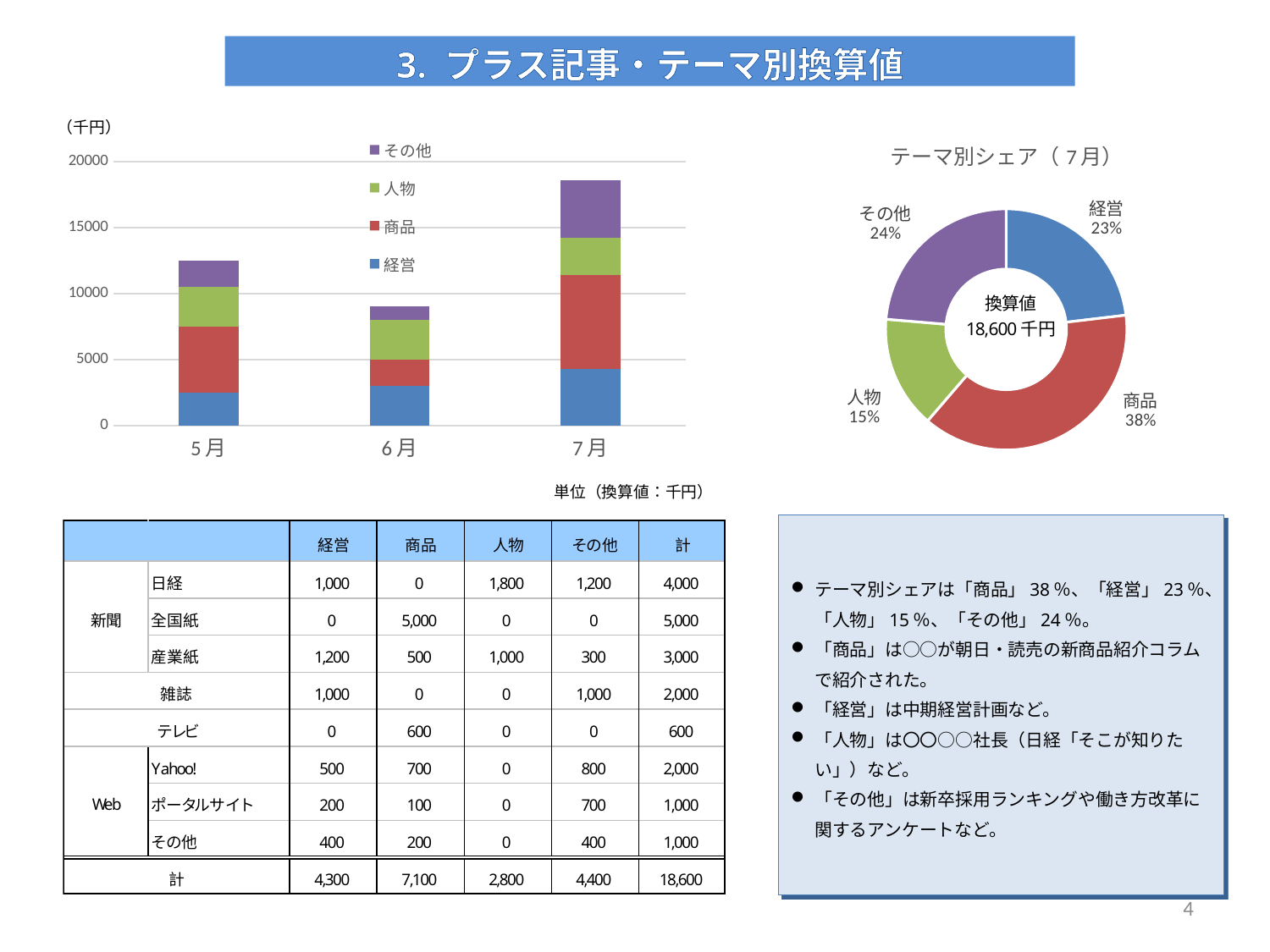
What kind of chart is the chart on the left of the slide? stacked bar chart In the left bar chart, is the total for 7月 greater or less than 15000? greater In the donut chart テーマ別シェア（7月）, what share does 商品 have? 38% In the left bar chart, which month has the shortest stacked bar? 6月 In the donut chart テーマ別シェア（7月）, what is the difference in percentage points between 商品 and 経営? 15 In the left bar chart, is the total for 6月 greater or less than 10000? less In the left bar chart, does the total rise or fall from 6月 to 7月? rises In the donut chart テーマ別シェア（7月）, which theme has the smallest share? 人物 How many series does the legend of the left bar chart list? 4 In the left bar chart, is the total for 5月 greater or less than 10000? greater How many months are shown on the x axis of the left bar chart? 3 In the left bar chart, which month has the tallest stacked bar? 7月